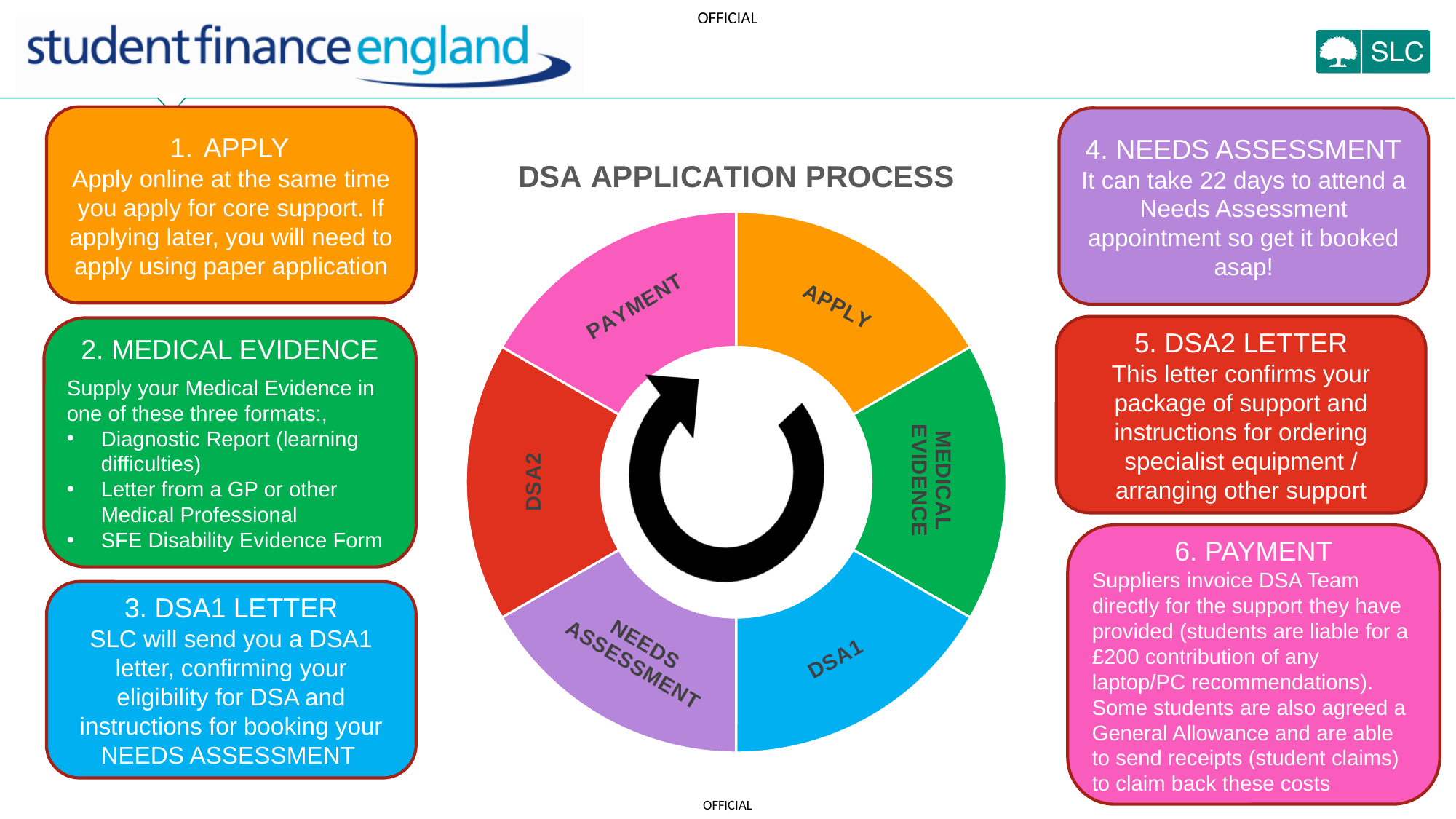
How many segments does the DSA APPLICATION PROCESS chart have? 6 Which segment label appears between DSA2 and DSA1 on the DSA APPLICATION PROCESS chart? NEEDS ASSESSMENT What is the title of the chart in the centre of the slide? DSA APPLICATION PROCESS What kind of chart is shown in the centre of the slide? Doughnut (pie) chart Which segment of the DSA APPLICATION PROCESS chart is coloured orange? APPLY Which segment label appears between APPLY and DSA1 on the DSA APPLICATION PROCESS chart? MEDICAL EVIDENCE